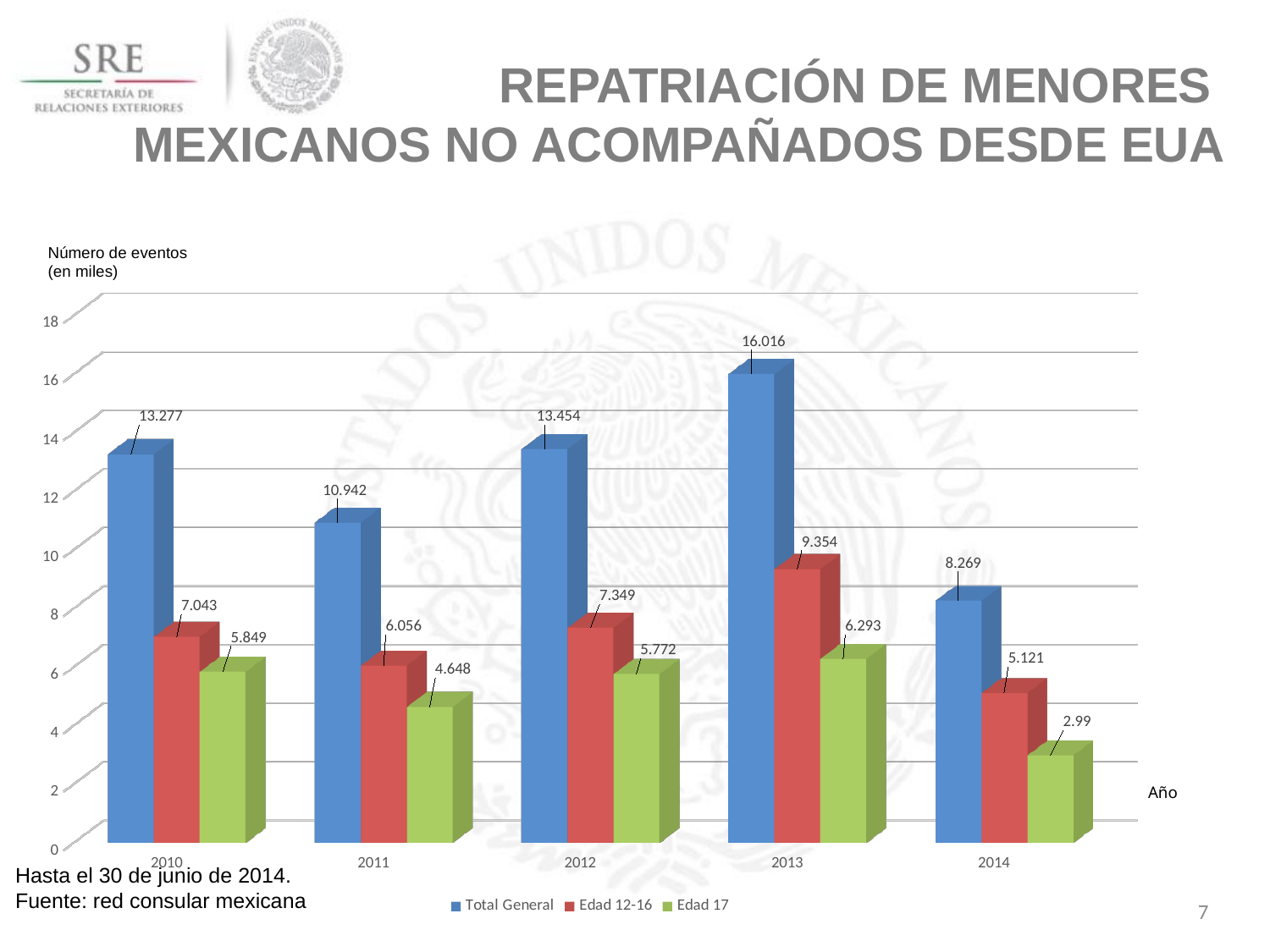
What is the value of Edad 12-16 for 2011? 6.056 What is the value of Edad 17 for 2014? 2.99 What is the difference between Total General in 2013 and Total General in 2012? 2.562 Which is larger: Edad 12-16 in 2010 or Edad 12-16 in 2012? Edad 12-16 in 2012 In which year is Total General highest? 2013 How many years are shown on the x axis? 5 Does Total General rise or fall from 2013 to 2014? fall In which year is Edad 17 lowest? 2014 What is the value of Total General for 2013? 16.016 What kind of chart is shown on the slide? bar chart Is the value of Total General for 2014 greater or less than 10? less How many series does the legend list? 3